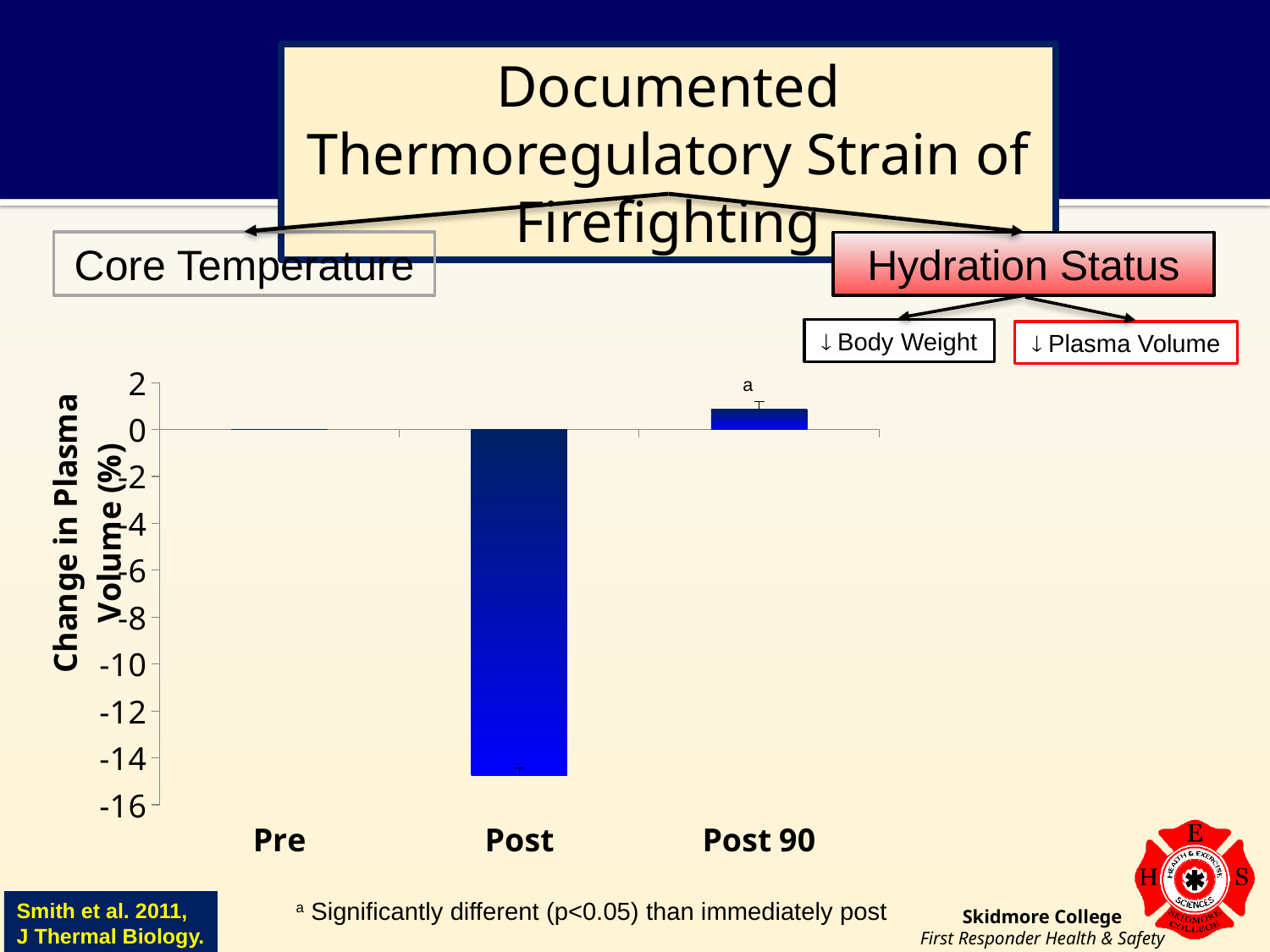
How many categories are shown on the x axis of the chart? 3 What kind of chart is shown on the slide? bar chart Which is larger, the value for Post or the value for Post 90? Post 90 Which category has the highest change in plasma volume? Post 90 What is the title of the y axis of the chart? Change in Plasma Volume (%) Is the value for Post greater or less than -12? less Is the value for Post greater or less than -10? less Is the value for Post 90 greater or less than 0? greater Which category's bar is marked with the superscript letter 'a'? Post 90 Does the change in plasma volume rise or fall from Pre to Post? fall Which category has the lowest change in plasma volume? Post